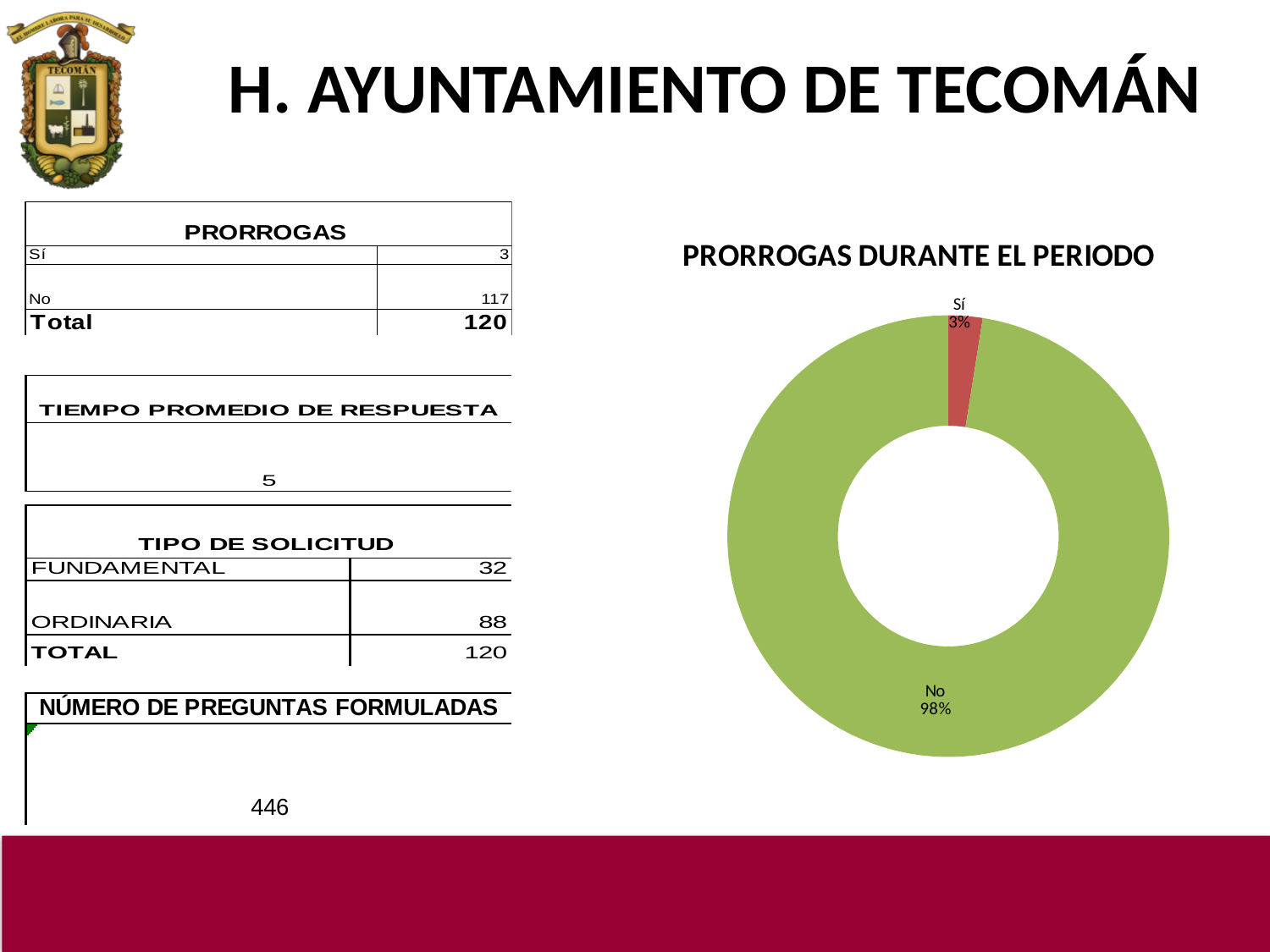
What share of the chart does the Sí slice represent? 3% What is the difference in percentage points between the No share and the Sí share in the chart? 95 Which category has the largest share in the chart? No How many categories are shown in the chart? 2 Which category has the smallest share in the chart? Sí What colour is the No slice in the chart? Green What percentage does the chart show for No? 98% What percentage does the chart show for Sí? 3% What is the title of the chart on the slide? PRORROGAS DURANTE EL PERIODO What kind of chart is shown on the slide? Doughnut chart Which is larger in the chart, the share for Sí or the share for No? No